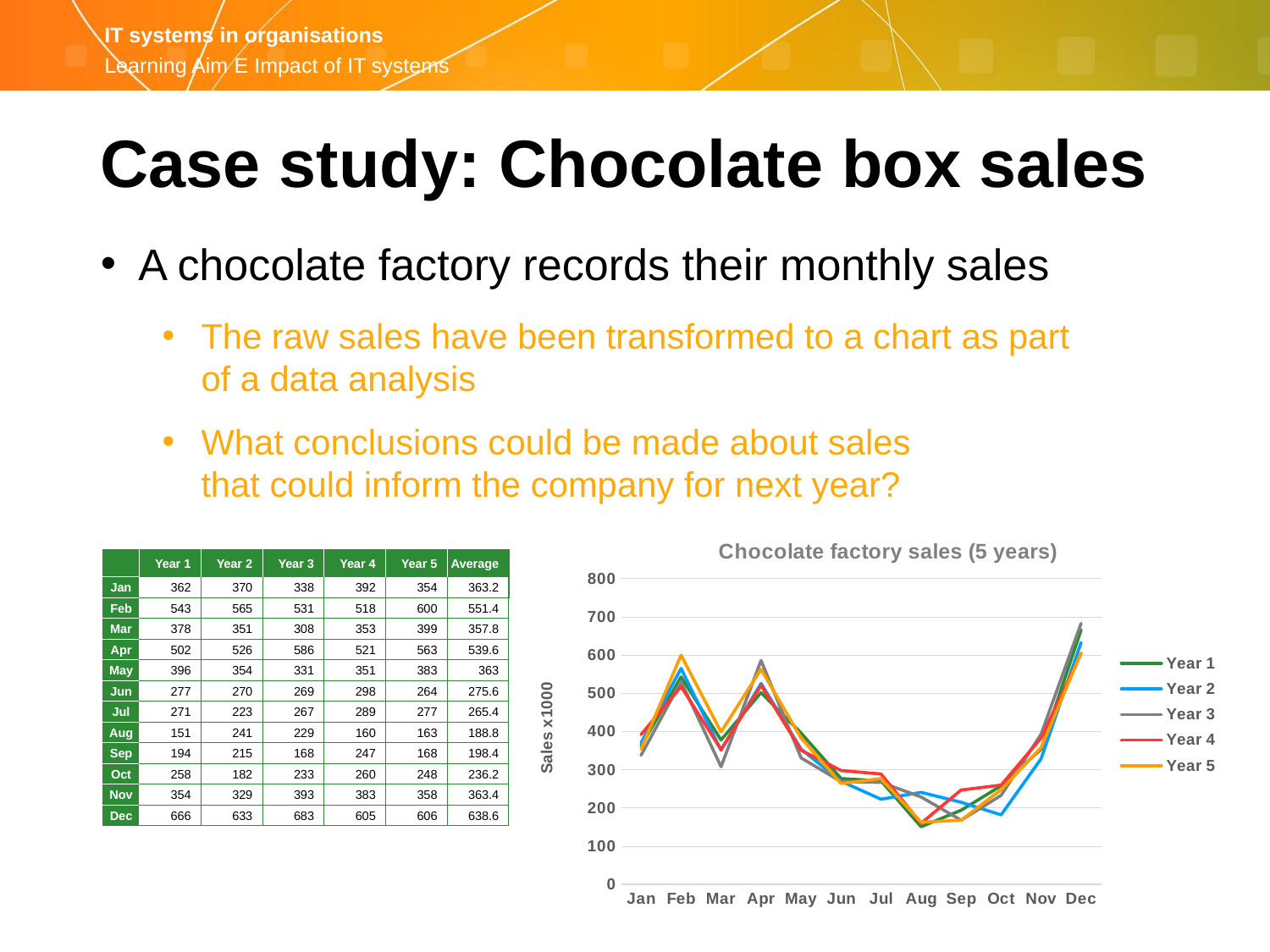
How many months are plotted along the x axis of the chart? 12 What is the title of the chart? Chocolate factory sales (5 years) What is the difference between the Year 5 sales for Feb and Jan? 246 Which is larger in Apr, the Year 3 value or the Year 2 value? Year 3 Do the Year 1 values rise or fall from Apr to Aug? fall How many series does the legend of the chart list? 5 Which month has the highest Year 1 sales? Dec What kind of chart is shown on the slide? Line chart What is the Year 5 sales value for Feb? 600 Which month has the lowest Year 2 sales? Oct Is the Year 4 value for Dec greater or less than 500? greater What is the Year 3 sales value for Dec? 683